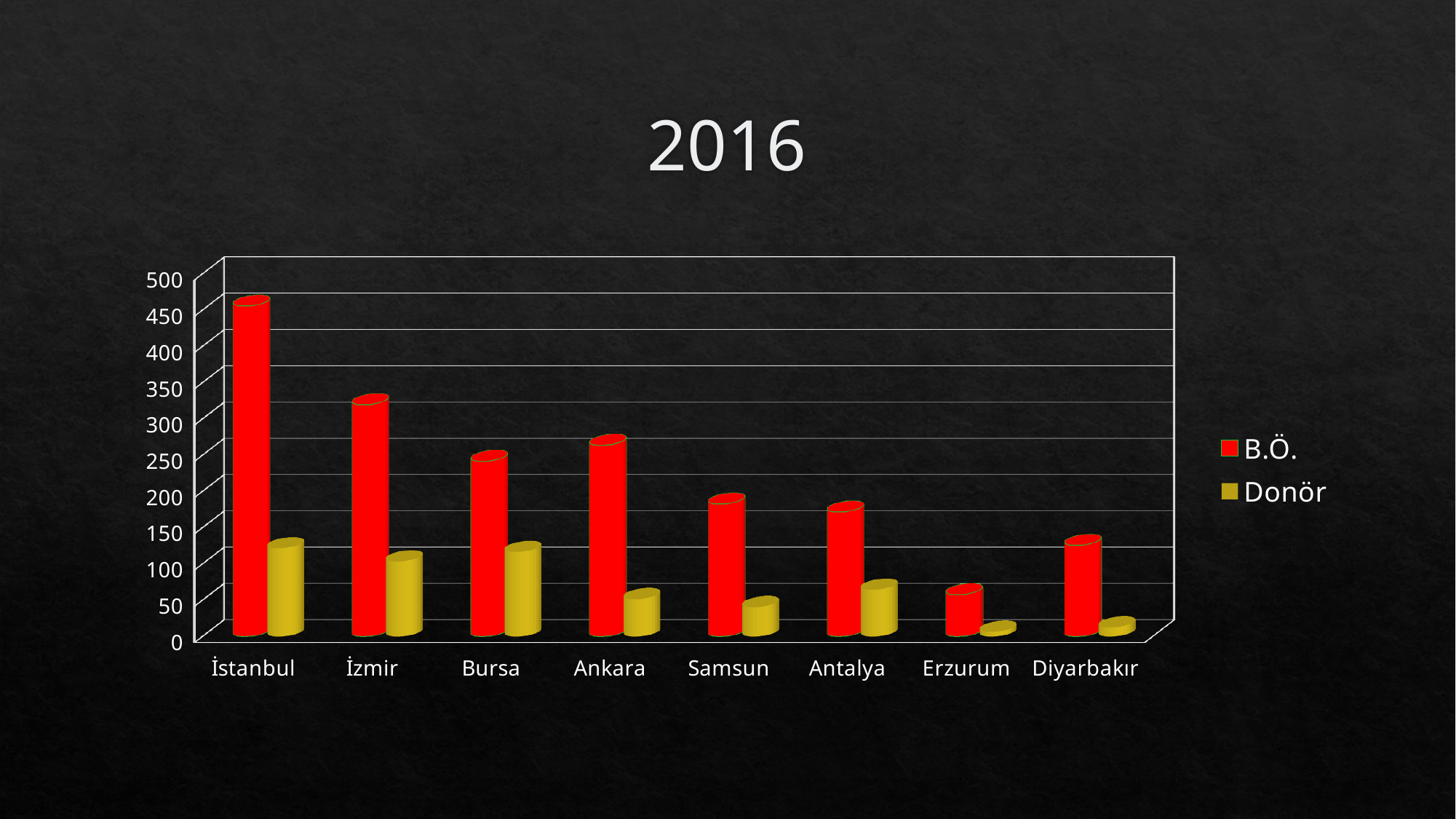
How many cities are shown on the x axis? 8 What is the title of the chart? 2016 Which is larger, the B.Ö. value for İzmir or for Ankara? İzmir Which is larger, the Donör value for Bursa or for Ankara? Bursa How many series does the legend list? 2 Which city has the highest B.Ö. value? İstanbul What kind of chart is shown on the slide? bar chart Is the B.Ö. value for İstanbul greater or less than 400? greater Is the Donör value for Ankara greater or less than 100? less Which city has the lowest B.Ö. value? Erzurum Is the B.Ö. value for Erzurum greater or less than 100? less